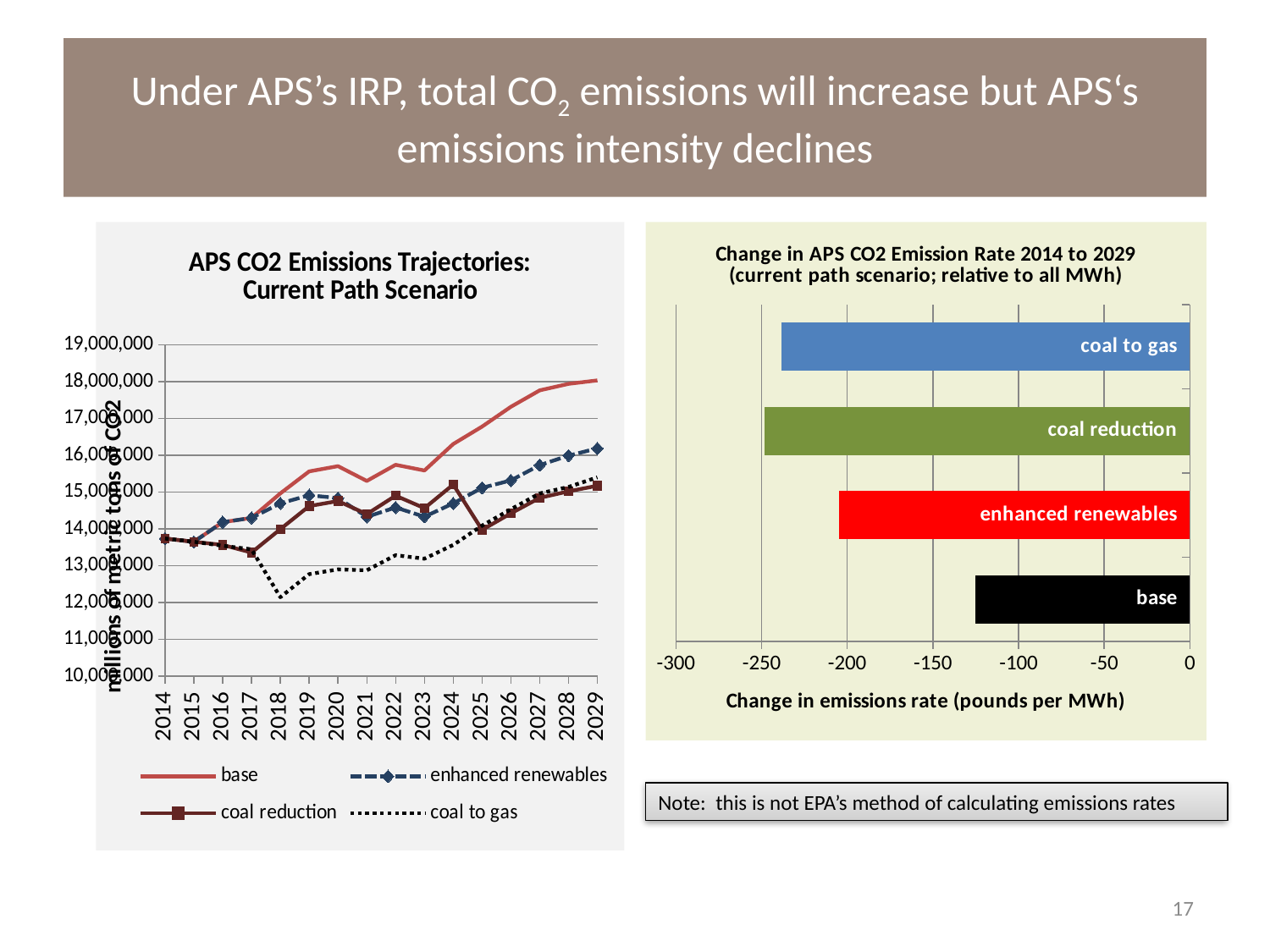
In the 'Change in APS CO2 Emission Rate 2014 to 2029' chart, is the value for base greater or less than -100? less In the 'APS CO2 Emissions Trajectories' chart, is the coal to gas value in 2018 greater or less than 13,000,000? less In the 'APS CO2 Emissions Trajectories' chart, is the base value in 2029 greater or less than 17,000,000? greater What type of chart is the 'Change in APS CO2 Emission Rate 2014 to 2029' chart? bar chart In the 'Change in APS CO2 Emission Rate 2014 to 2029' chart, how many bars are shown? 4 In the 'APS CO2 Emissions Trajectories' chart, how many years are shown on the x axis? 16 In the 'Change in APS CO2 Emission Rate 2014 to 2029' chart, which scenario has the smallest change in emissions rate (closest to 0)? base In the 'APS CO2 Emissions Trajectories' chart, how many series does the legend list? 4 In the 'APS CO2 Emissions Trajectories' chart, which series has the highest value in 2029? base In the 'APS CO2 Emissions Trajectories' chart, does the base series generally rise or fall from 2014 to 2029? rise In the 'APS CO2 Emissions Trajectories' chart, which series has the lowest value in 2018? coal to gas What type of chart is the 'APS CO2 Emissions Trajectories: Current Path Scenario' chart? line chart